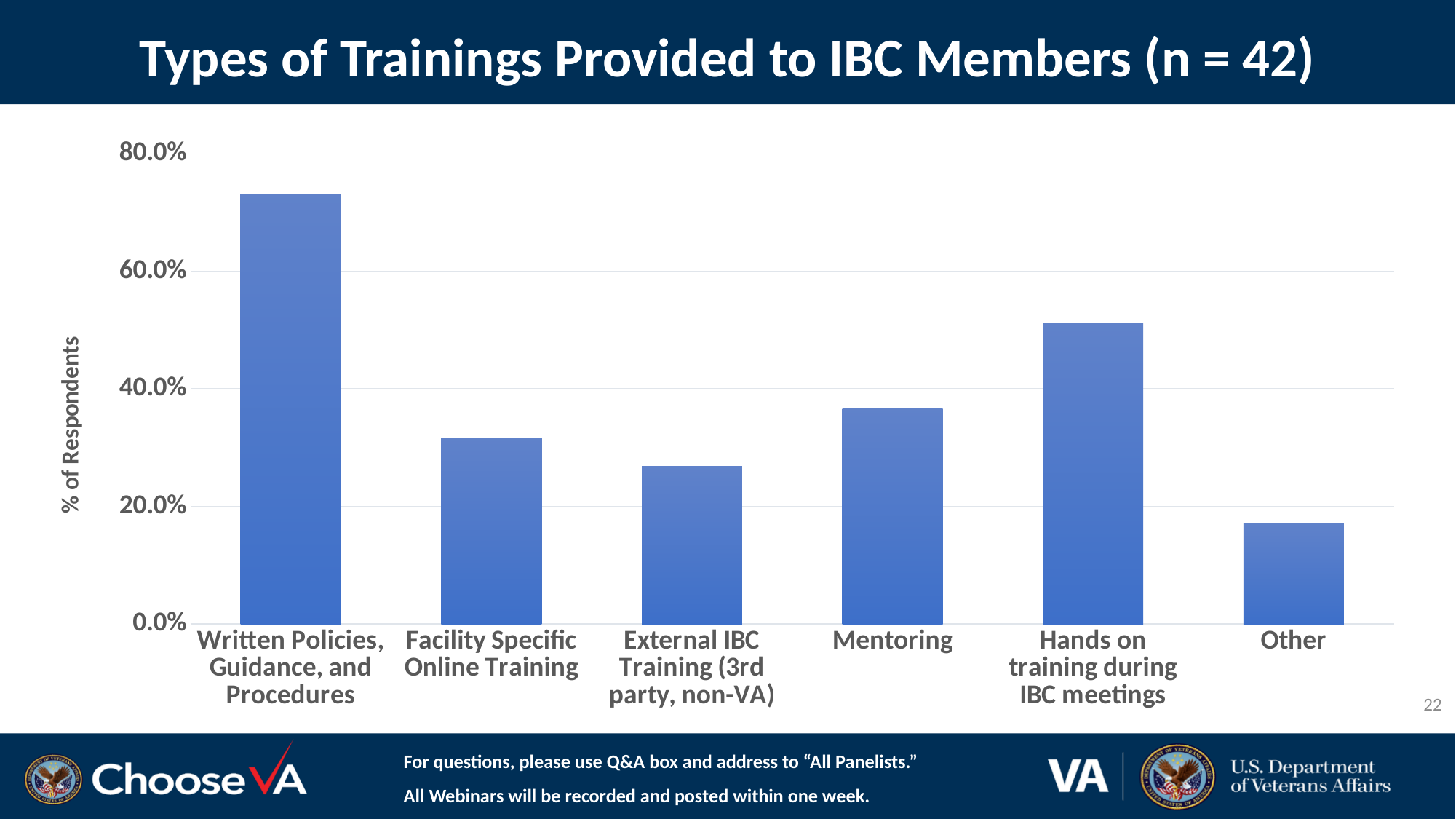
Is the value for Hands on training during IBC meetings greater or less than 40.0%? greater Is the value for Other greater or less than 20.0%? less What is the title of the chart? Types of Trainings Provided to IBC Members (n = 42) Which training type has the highest percentage of respondents? Written Policies, Guidance, and Procedures Which training type has the lowest percentage of respondents? Other Is the value for External IBC Training (3rd party, non-VA) greater or less than 40.0%? less Which is larger: the value for Hands on training during IBC meetings or the value for Mentoring? Hands on training during IBC meetings Which is larger: the value for Mentoring or the value for Facility Specific Online Training? Mentoring What is the label on the vertical axis of the chart? % of Respondents How many training types (categories) are shown on the chart? 6 What type of chart is shown on the slide? bar chart